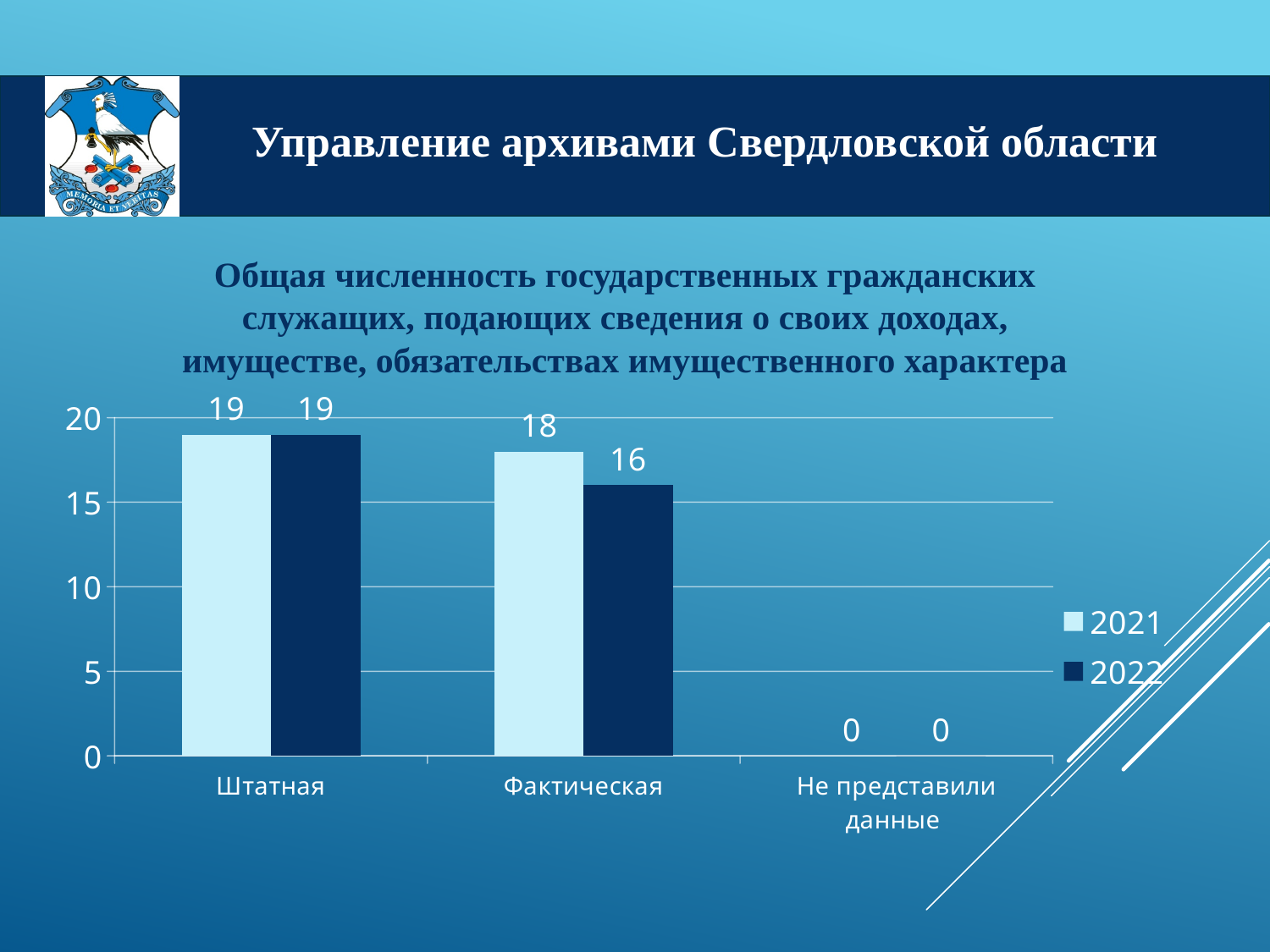
Which category has the highest value in the 2022 series? Штатная How many series does the legend list? 2 What is the value for Фактическая in the 2021 series? 18 What is the value for Не представили данные in the 2022 series? 0 What is the difference between the 2021 and 2022 values for Фактическая? 2 How many categories are shown on the x axis? 3 Which series is shown in dark blue in the legend? 2022 What is the value for Фактическая in the 2022 series? 16 Which category has the lowest value in the 2021 series? Не представили данные What kind of chart is shown on the slide? bar chart What is the value for Штатная in the 2021 series? 19 Which is larger for Фактическая: the 2021 value or the 2022 value? 2021